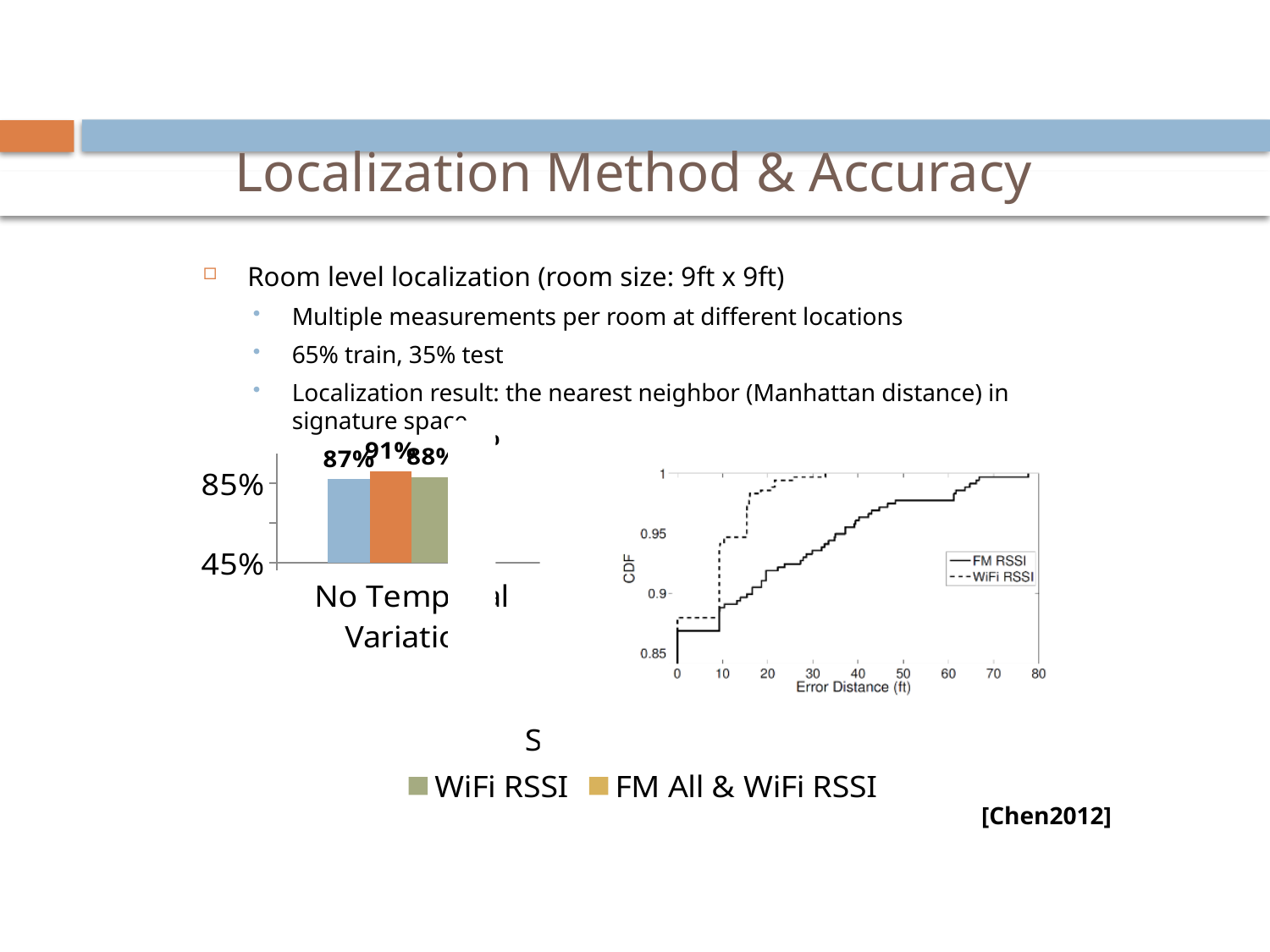
In the bar chart on the left, what is the value for WiFi RSSI? 88% In the bar chart on the left, is the value for WiFi RSSI greater or less than 85%? greater In the CDF chart on the right, how many series does the legend list? 2 In the bar chart on the left, what is the lowest value shown on the data labels? 87% In the bar chart on the left, is the 87% bar larger or smaller than the 91% bar? smaller In the bar chart on the left, what is the highest value shown on the data labels? 91% In the bar chart on the left, what is the difference between the highest bar (91%) and the lowest bar (87%)? 4 percentage points What kind of chart is the chart on the left of the slide? Bar chart In the CDF chart on the right, which two series are named in the legend? FM RSSI and WiFi RSSI What kind of chart is the chart on the right of the slide (the CDF plot)? Line chart In the CDF chart on the right, what is the label of the x axis? Error Distance (ft)